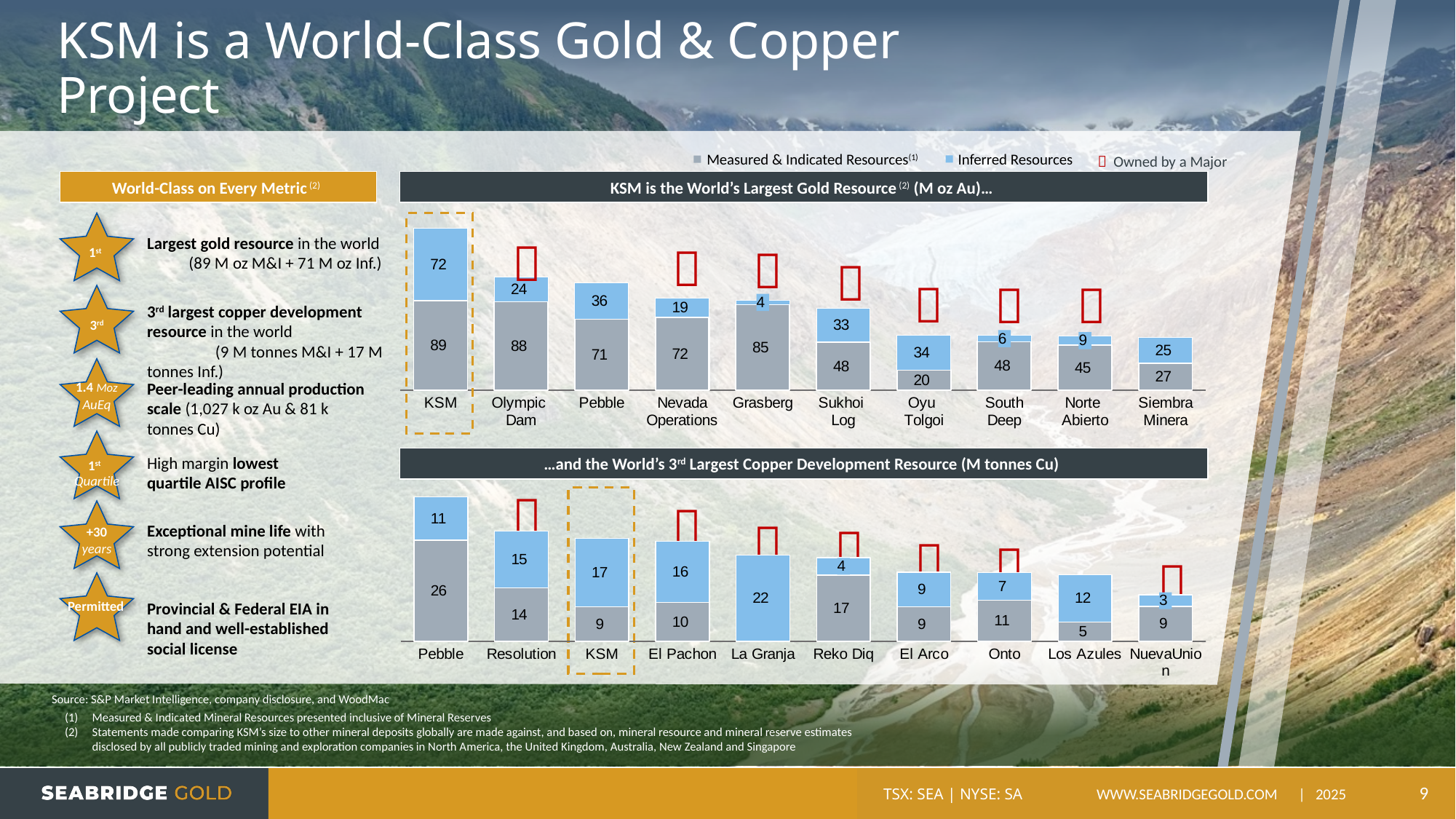
In the gold resource chart, what is the total of the stacked bar for KSM? 161 In the gold resource chart, what is the Measured & Indicated Resources value for KSM? 89 In the gold resource chart, what is the Inferred Resources value for Sukhoi Log? 33 In the gold resource chart, what is the difference between the Measured & Indicated values for Olympic Dam and Pebble? 17 In the copper development resource chart, which is larger: the Measured & Indicated value for Reko Diq or for Onto? Reko Diq In the gold resource chart, which deposit has the lowest Measured & Indicated Resources value? Oyu Tolgoi In the copper development resource chart, what is the total of the stacked bar for Pebble? 37 What type of chart is used for the copper development resource chart? Stacked bar chart How many series does the legend list for the stacked bars? 2 In the copper development resource chart, which deposit has the highest Measured & Indicated Resources value? Pebble In the gold resource chart, how many deposits are shown on the x axis? 10 In the copper development resource chart, what is the Inferred Resources value for KSM? 17